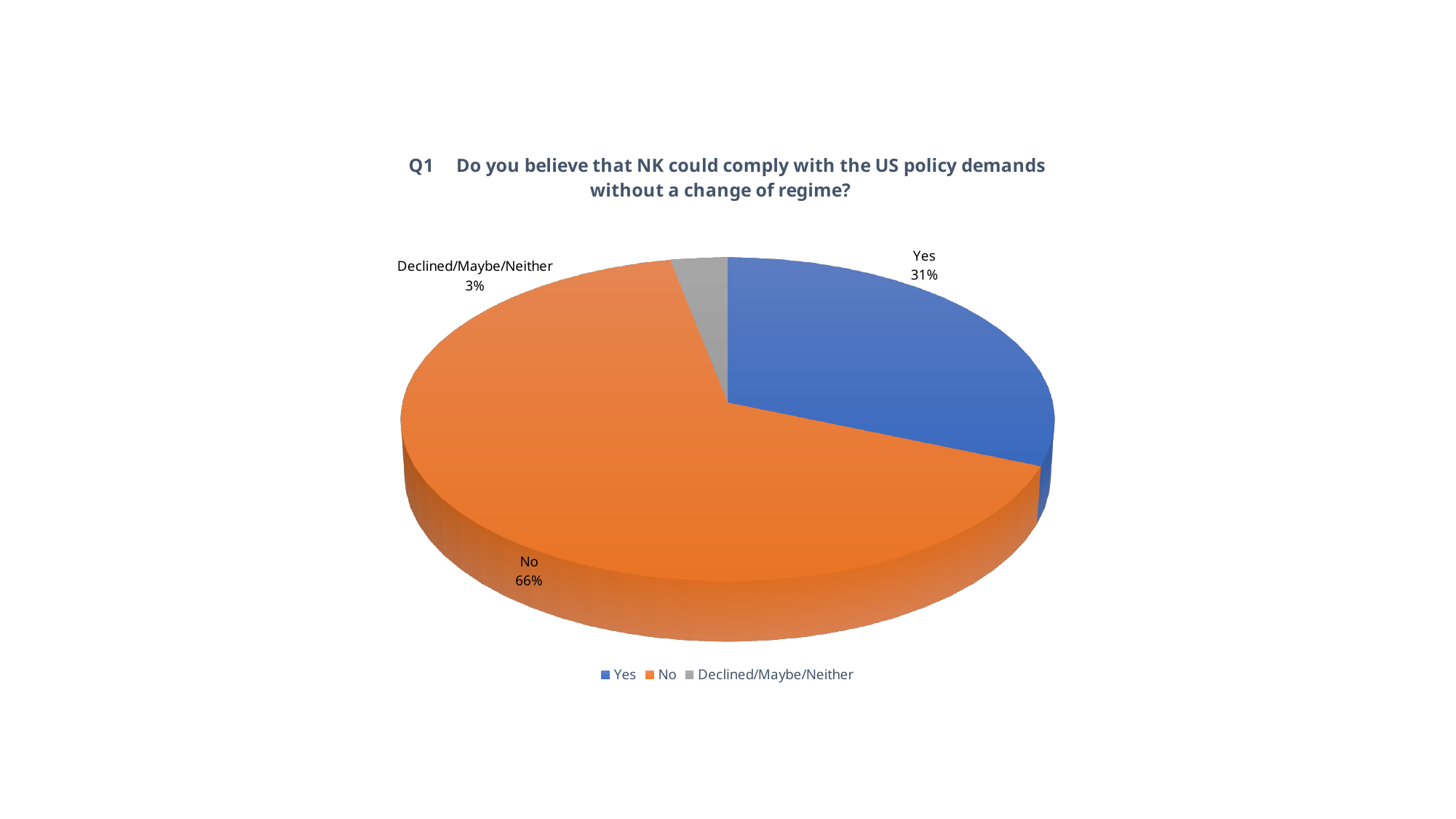
What is the difference in percentage points between the "No" and "Yes" slices? 35 Which is larger, the "Yes" slice or the "Declined/Maybe/Neither" slice? Yes Which category has the smallest slice of the pie? Declined/Maybe/Neither What kind of chart is shown on the slide? Pie chart What share of the pie does the "No" slice represent? 66% Which category has the largest slice of the pie? No How many entries does the legend list? 3 What share of the pie does the "Yes" slice represent? 31% How many categories are shown in the pie chart? 3 What share of the pie does the "Declined/Maybe/Neither" slice represent? 3% What colour is the "No" slice of the pie? Orange What is the title of the chart? Q1 Do you believe that NK could comply with the US policy demands without a change of regime?